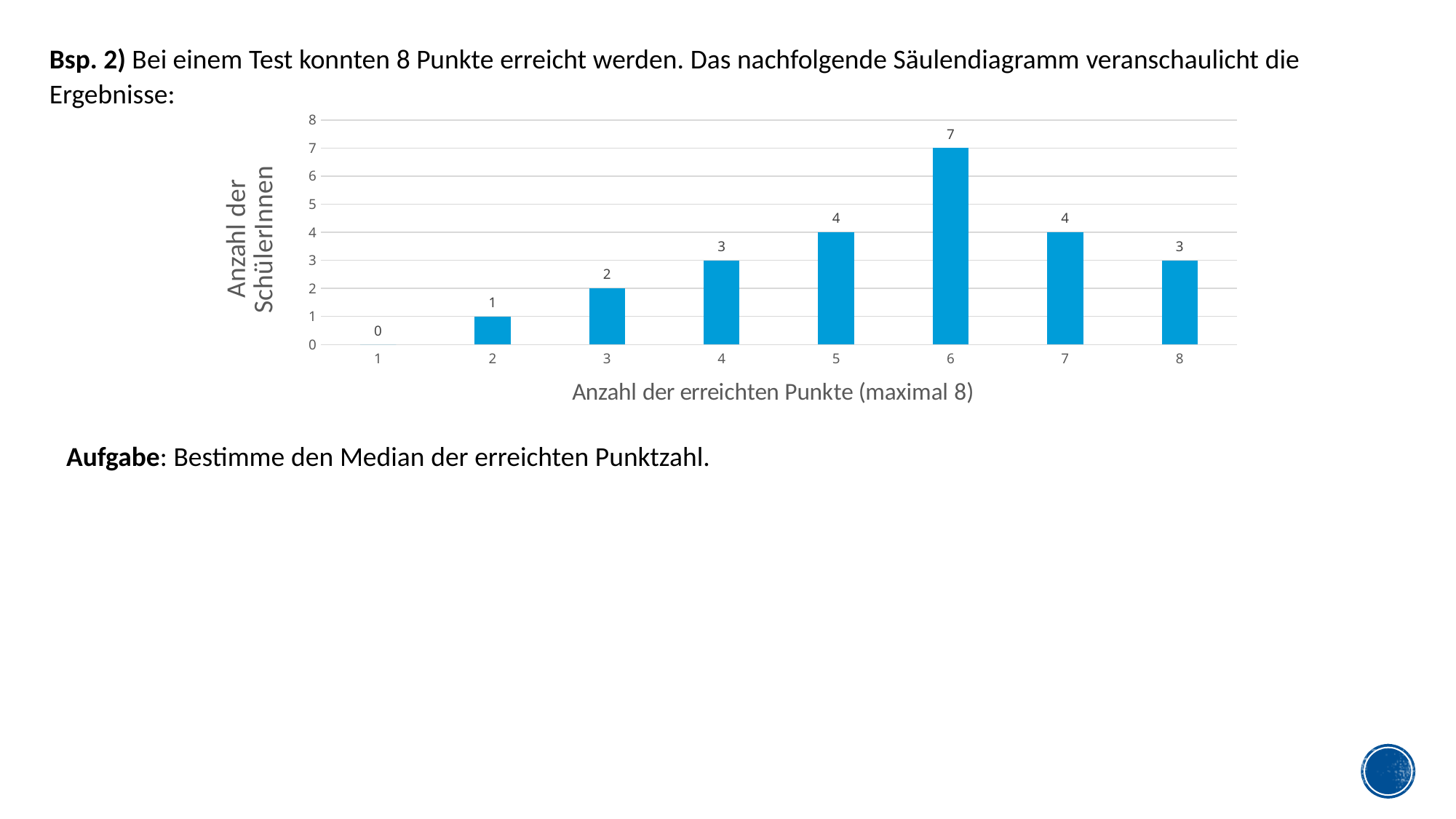
What is the label of the x axis? Anzahl der erreichten Punkte (maximal 8) Is the number of students with 6 points greater or less than 5? greater How many students achieved 4 points? 3 How many students achieved 1 point? 0 Which has more students: 3 points or 7 points? 7 points How many students achieved 6 points? 7 How many point-score categories are shown on the x axis? 8 Which point score was achieved by the fewest students? 1 What is the difference between the number of students with 6 points and the number with 5 points? 3 What kind of chart is shown on the slide? bar chart What is the label of the y axis? Anzahl der SchülerInnen Which point score was achieved by the most students? 6